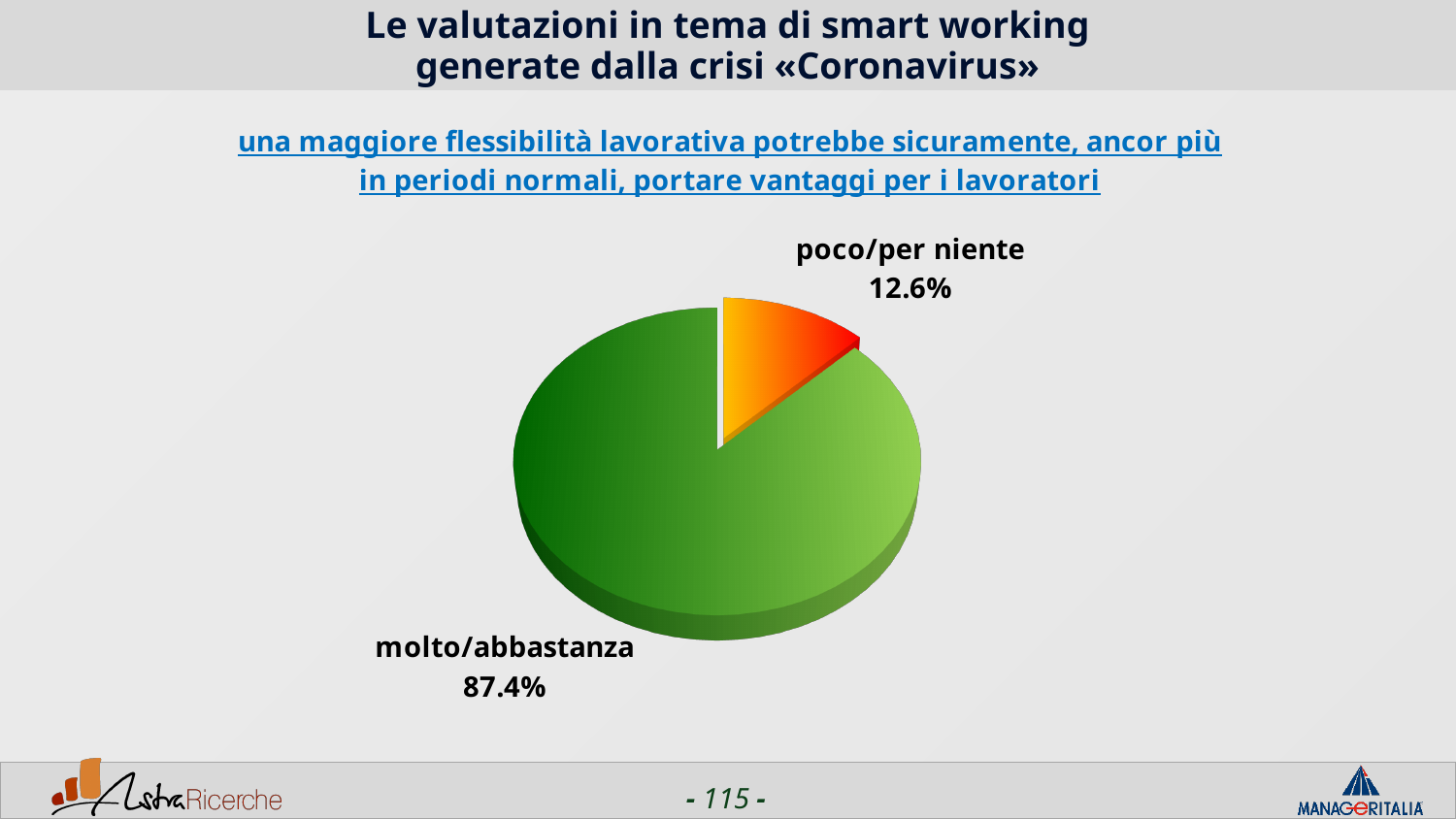
What is the total of the two slices shown in the pie chart? 100% What colour is the "poco/per niente" slice? orange/red What share of the pie is labelled "poco/per niente"? 12.6% Which slice of the pie is the largest? molto/abbastanza Which is larger, the "molto/abbastanza" slice or the "poco/per niente" slice? molto/abbastanza What share of the pie is labelled "molto/abbastanza"? 87.4% How many slices does the pie chart have? 2 Which slice of the pie is the smallest? poco/per niente What kind of chart is shown on the slide? pie chart What colour is the "molto/abbastanza" slice? green What is the difference in percentage points between the "molto/abbastanza" and "poco/per niente" slices? 74.8